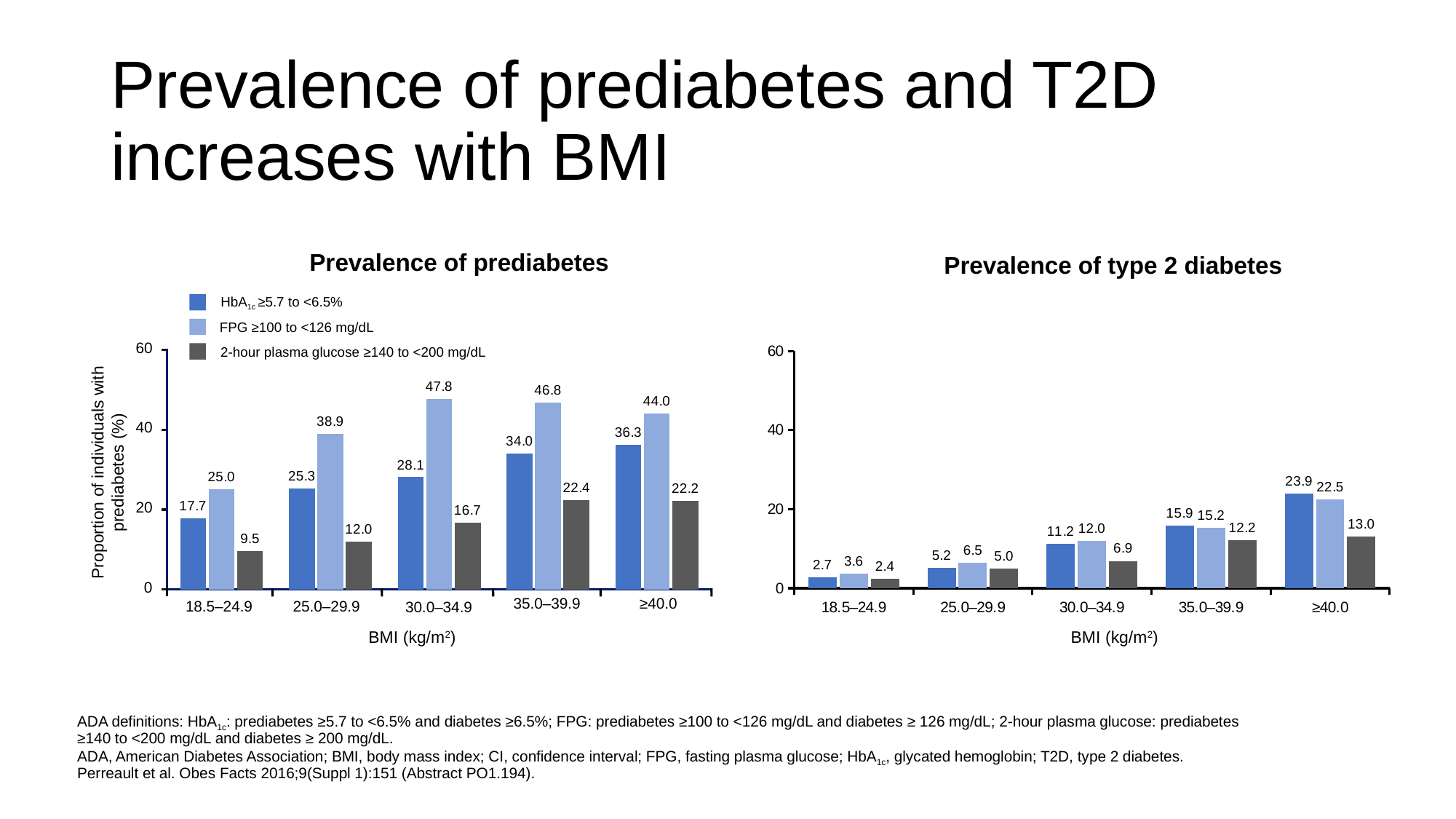
In the 'Prevalence of type 2 diabetes' chart, what is the value of the light blue bar for the BMI 30.0–34.9 group? 12.0 In the 'Prevalence of prediabetes' chart, which BMI group has the highest 2-hour plasma glucose ≥140 to <200 mg/dL value? 35.0–39.9 In the 'Prevalence of prediabetes' chart, how many series does the legend list? 3 In the 'Prevalence of prediabetes' chart, what is the FPG ≥100 to <126 mg/dL value for the BMI 30.0–34.9 group? 47.8 In the 'Prevalence of type 2 diabetes' chart, do the dark blue bar values rise or fall as BMI increases along the x axis? rise In the 'Prevalence of type 2 diabetes' chart, which BMI group has the highest dark blue bar? ≥40.0 In the 'Prevalence of prediabetes' chart, which BMI group has the lowest HbA1c ≥5.7 to <6.5% value? 18.5–24.9 What kind of chart is the 'Prevalence of type 2 diabetes' chart? bar chart In the 'Prevalence of prediabetes' chart, what is the HbA1c ≥5.7 to <6.5% value for the BMI 18.5–24.9 group? 17.7 In the 'Prevalence of type 2 diabetes' chart, how many BMI groups are shown on the x axis? 5 In the 'Prevalence of prediabetes' chart, what is the difference between the FPG and HbA1c values for the BMI 25.0–29.9 group? 13.6 In the 'Prevalence of type 2 diabetes' chart, what is the value of the grey bar for the BMI ≥40.0 group? 13.0